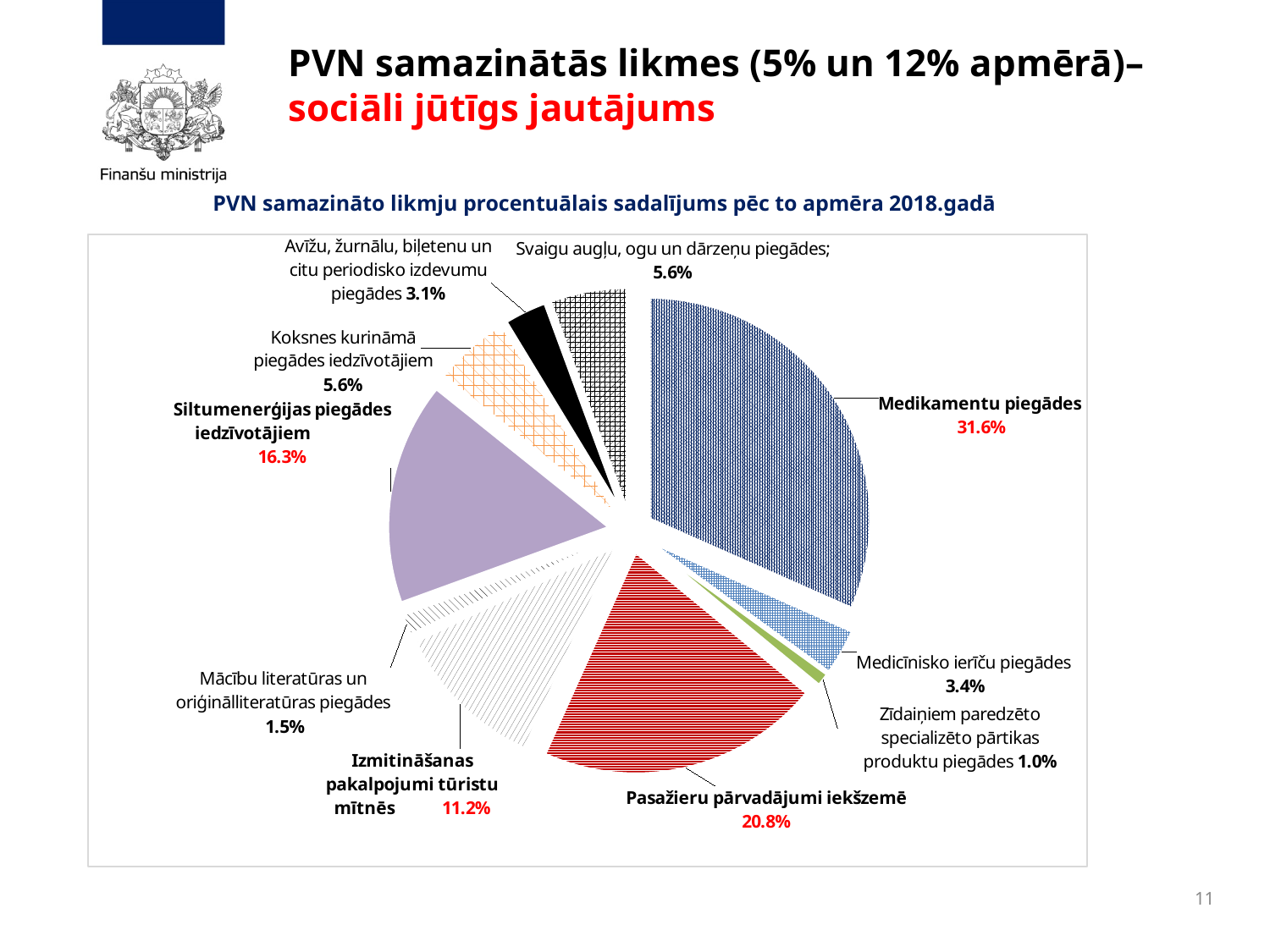
What is the share for Siltumenerģijas piegādes iedzīvotājiem? 16.3% What is the share for Medikamentu piegādes? 31.6% What is the share for Pasažieru pārvadājumi iekšzemē? 20.8% Which is larger: the share for Medicīnisko ierīču piegādes or the share for Avīžu, žurnālu, biļetenu un citu periodisko izdevumu piegādes? Medicīnisko ierīču piegādes What type of chart is shown on the slide? Pie chart What is the title of the chart? PVN samazināto likmju procentuālais sadalījums pēc to apmēra 2018.gadā Which category has the largest share of the pie? Medikamentu piegādes What is the share for Izmitināšanas pakalpojumi tūristu mītnēs? 11.2% What is the difference in percentage points between Medikamentu piegādes and Pasažieru pārvadājumi iekšzemē? 10.8 Which category has the smallest share of the pie? Zīdaiņiem paredzēto specializēto pārtikas produktu piegādes What is the share for Zīdaiņiem paredzēto specializēto pārtikas produktu piegādes? 1.0% How many categories (slices) does the pie chart have? 10